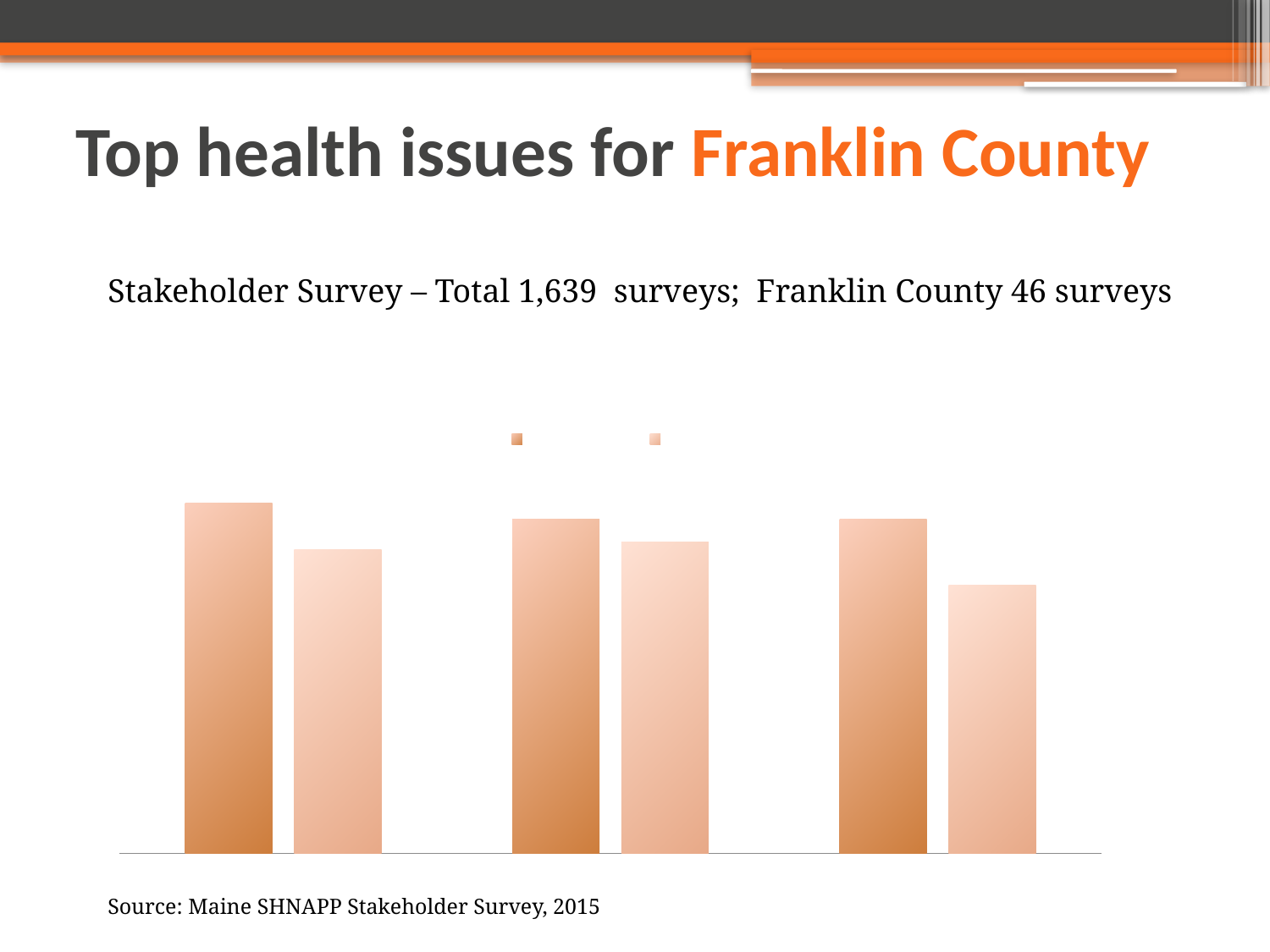
Which group of bars contains the tallest bar on the chart: the leftmost, middle, or rightmost? the leftmost How many bars are plotted on the chart in total? 6 How many groups of bars (categories) does the chart show? 3 Are the bars on the chart vertical or horizontal? vertical What kind of chart is shown on the slide? bar chart In the rightmost group of bars, is the darker orange bar or the lighter orange bar taller? the darker orange bar In the leftmost group of bars, is the darker orange bar or the lighter orange bar taller? the darker orange bar Which group of bars contains the shortest bar on the chart: the leftmost, middle, or rightmost? the rightmost In the middle group of bars, is the darker orange bar or the lighter orange bar taller? the darker orange bar How many series does the chart's legend list? 2 What colours are the two series of bars on the chart? darker orange and lighter orange Do the lighter orange bars rise or fall from the leftmost group to the rightmost group? neither; they rise from the leftmost to the middle group, then fall to the rightmost group